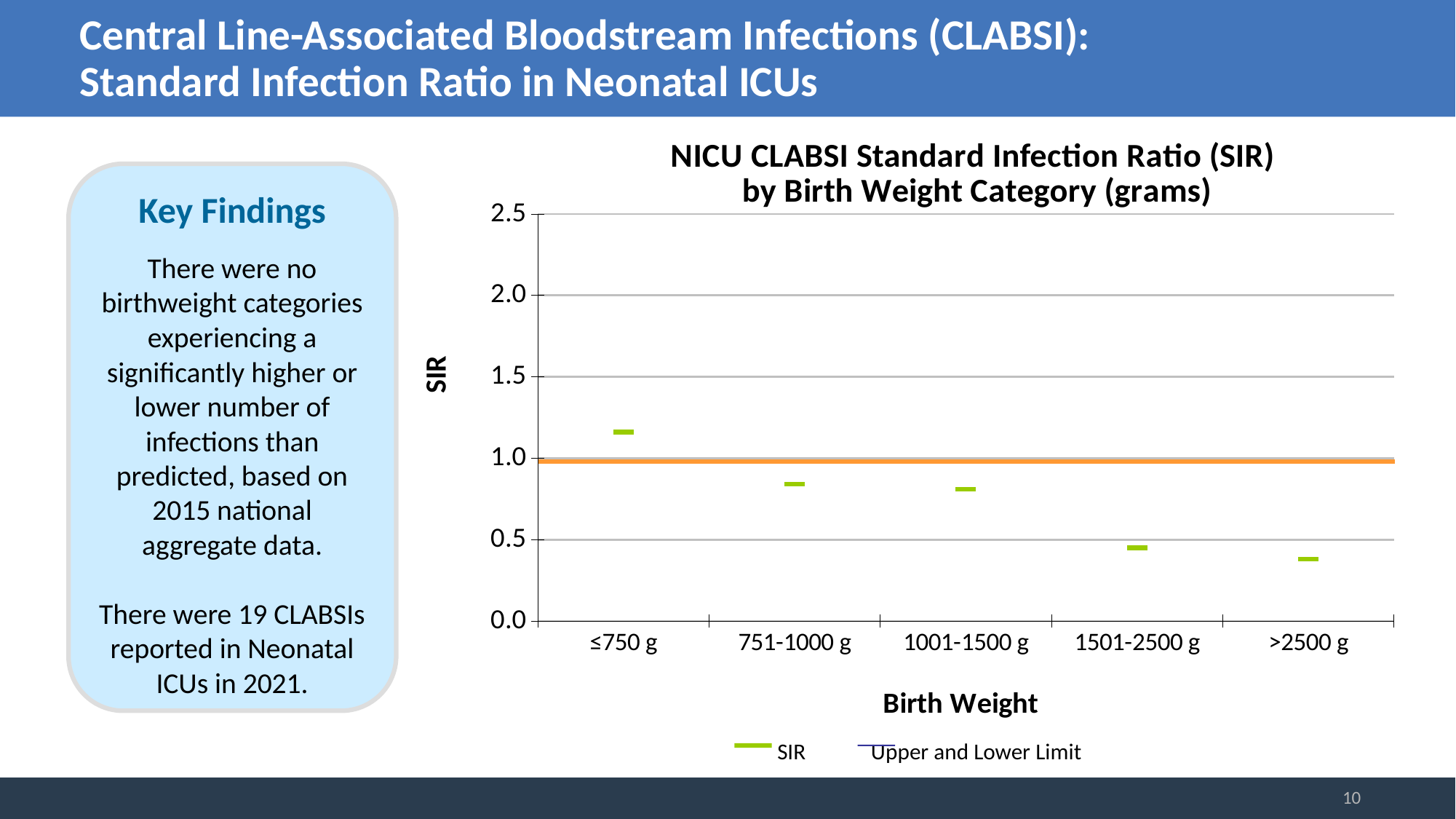
How many series does the chart legend list? 2 What is the label of the y axis of the chart? SIR Which has a higher SIR: the ≤750 g category or the >2500 g category? ≤750 g Is the SIR for the 751-1000 g category greater or less than 1.0? less Which has a higher SIR: the 1001-1500 g category or the 1501-2500 g category? 1001-1500 g Which birth weight category has the lowest SIR? >2500 g Is the SIR for the 1501-2500 g category greater or less than 0.5? less Which birth weight category has the highest SIR? ≤750 g Do the SIR values generally rise or fall as birth weight increases along the x axis? fall How many birth weight categories are shown on the x axis of the chart? 5 Is the SIR for the ≤750 g category greater or less than 1.0? greater